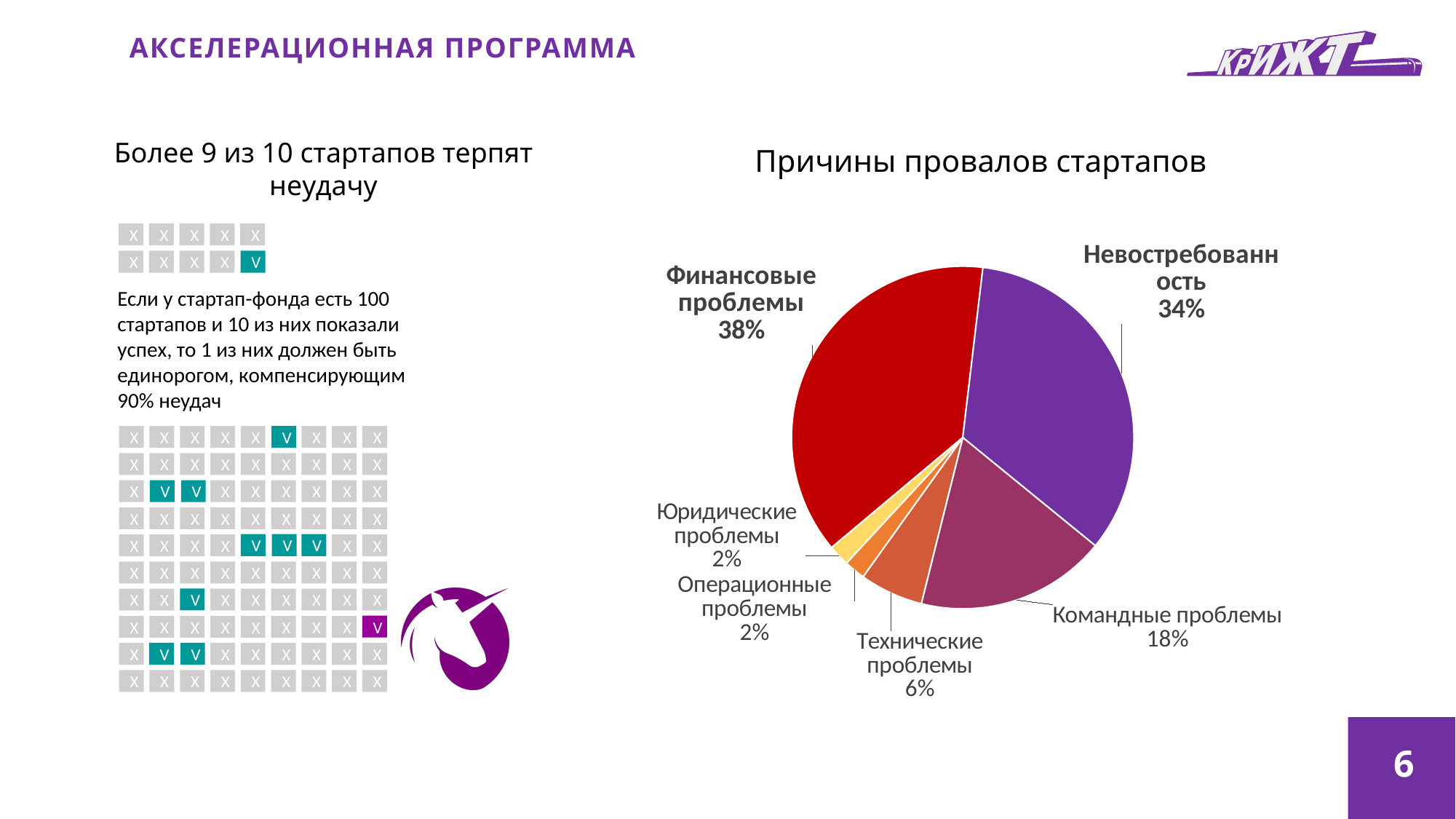
What percentage does the pie chart show for "Технические проблемы"? 6% What colour is the "Финансовые проблемы" slice in the pie chart? Red What percentage does the pie chart show for "Невостребованность"? 34% How many slices does the pie chart "Причины провалов стартапов" have? 6 Which cause of startup failure has the largest slice in the pie chart? Финансовые проблемы What percentage does the pie chart show for "Командные проблемы"? 18% What is the combined share of "Юридические проблемы" and "Операционные проблемы" in the pie chart? 4% What share of the pie chart is labelled "Финансовые проблемы"? 38% What is the difference in percentage points between "Финансовые проблемы" and "Невостребованность" in the pie chart? 4 What type of chart is shown under the title "Причины провалов стартапов"? Pie chart Which is larger in the pie chart: "Командные проблемы" or "Технические проблемы"? Командные проблемы What is the title of the pie chart on the slide? Причины провалов стартапов